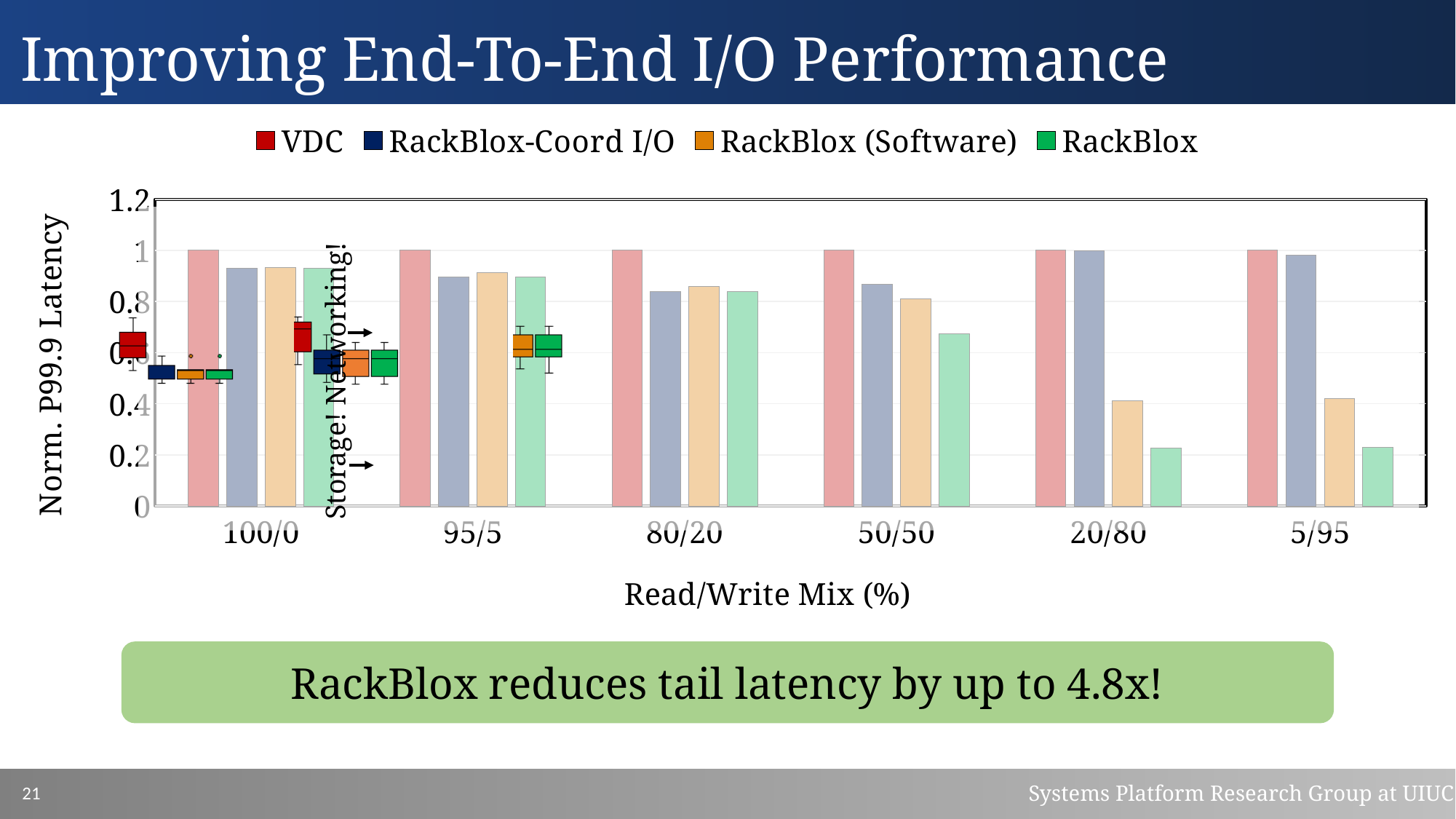
What is the label of the x axis? Read/Write Mix (%) Is the value for RackBlox (Software) at the 95/5 read/write mix greater or less than 0.8? greater What is the normalized P99.9 latency of VDC at the 5/95 read/write mix? 1 How many series does the legend list? 4 Do the RackBlox bars generally rise or fall moving from 100/0 to 5/95 along the x axis? fall Is the value for RackBlox at the 20/80 read/write mix greater or less than 0.4? less Is the value for RackBlox at the 50/50 read/write mix greater or less than 0.8? less Which series has the lowest normalized P99.9 latency at the 20/80 read/write mix? RackBlox What kind of chart is shown on the slide? bar chart How many read/write mix categories are shown on the x axis? 6 At the 50/50 read/write mix, which is larger: RackBlox-Coord I/O or RackBlox? RackBlox-Coord I/O At the 20/80 read/write mix, which is larger: RackBlox (Software) or RackBlox? RackBlox (Software)